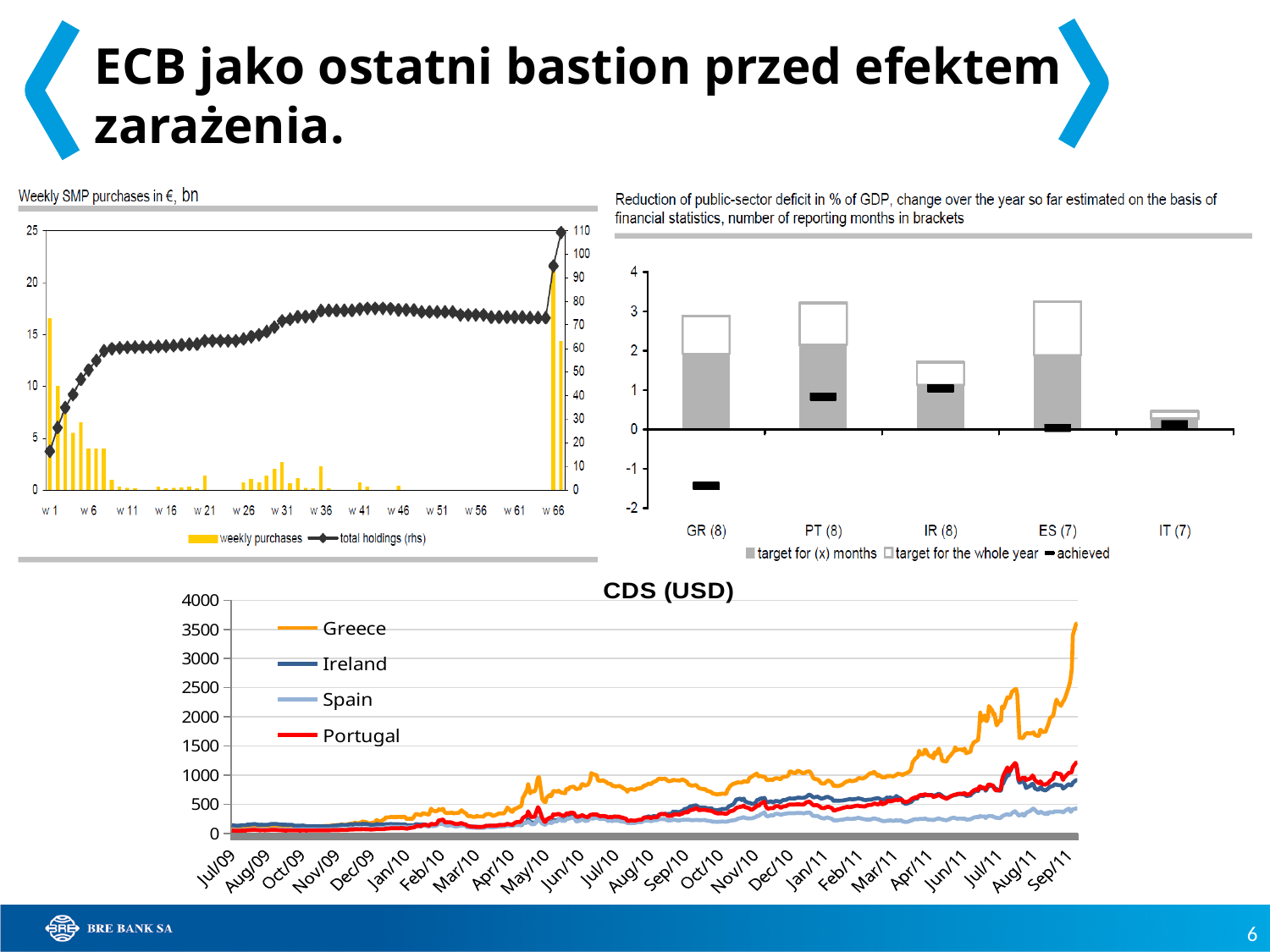
On the CDS (USD) chart, does the Greece series generally rise or fall from Jul/09 to Sep/11? rise On the 'Reduction of public-sector deficit' chart, is the 'achieved' value for GR (8) greater or less than -1? less On the CDS (USD) chart, which country has the lowest CDS value at the end of the period (Sep/11)? Spain What kind of chart is the CDS (USD) chart? line chart On the 'Weekly SMP purchases' chart, is the total holdings value at w 66 greater or less than 100 on the right-hand axis? greater On the CDS (USD) chart, is the value for Greece at Sep/11 greater or less than 3000? greater On the 'Weekly SMP purchases' chart, what are the two legend entries? weekly purchases; total holdings (rhs) On the CDS (USD) chart, how many series does the legend list? 4 On the 'Reduction of public-sector deficit' chart, how many countries are shown on the x axis? 5 On the CDS (USD) chart, which country has the highest CDS value at the end of the period (Sep/11)? Greece On the 'Reduction of public-sector deficit' chart, which country has the lowest 'achieved' value? GR (8)